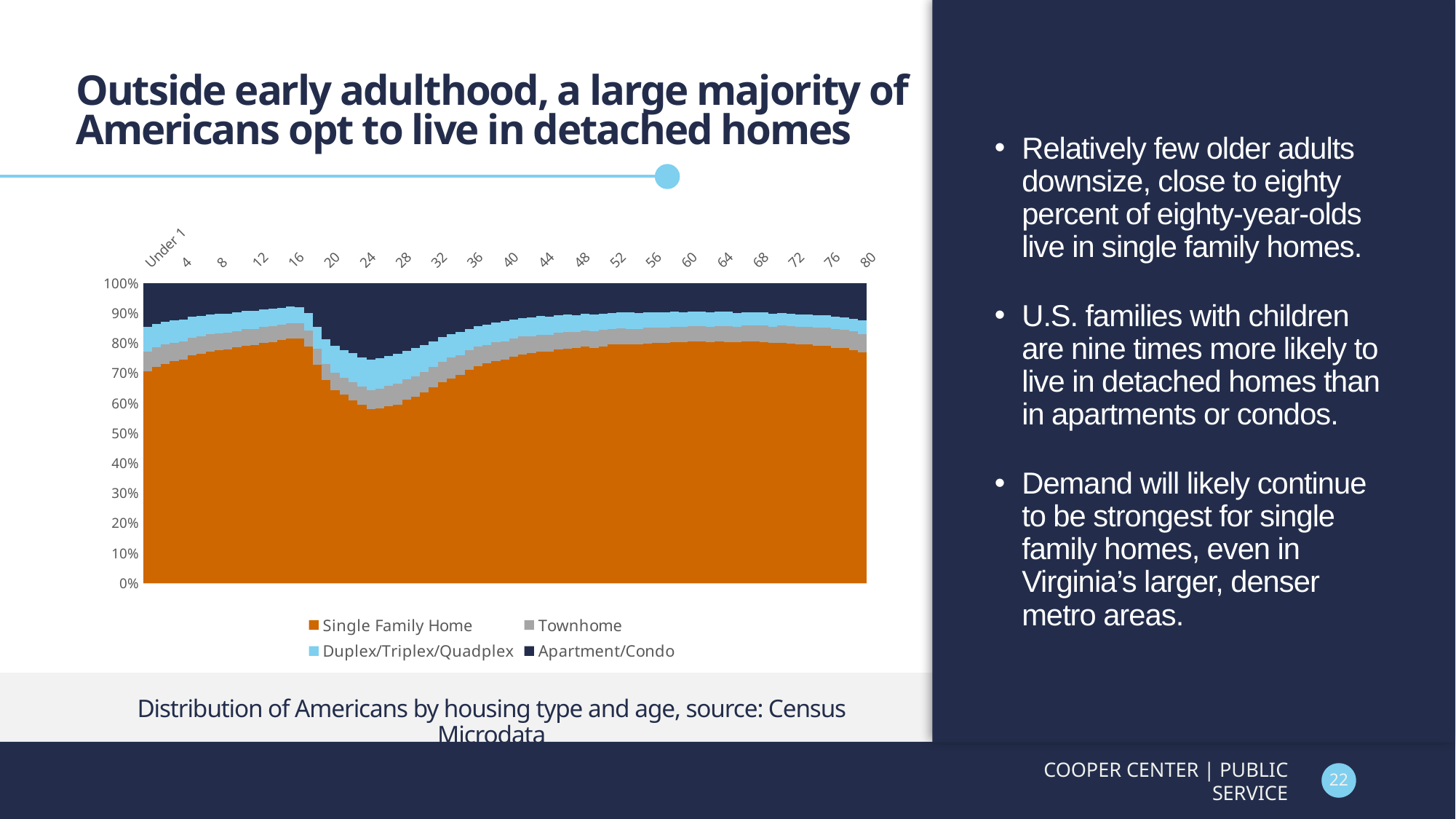
How many series does the chart legend list? 4 Which series is shown in orange in the chart? Single Family Home Is the Single Family Home share at age 48 greater or less than 60%? greater Does the Single Family Home share rise or fall between ages 24 and 40? rise Which series is shown in dark navy at the top of the stack? Apartment/Condo Is the Single Family Home share at age 16 greater or less than 70%? greater Does the Single Family Home share rise or fall between ages 16 and 24? fall Which is larger at age 24: the Single Family Home share or the Apartment/Condo share? Single Family Home Is the Single Family Home share at age 80 greater or less than 70%? greater What is the highest value shown on the chart's vertical axis? 100%